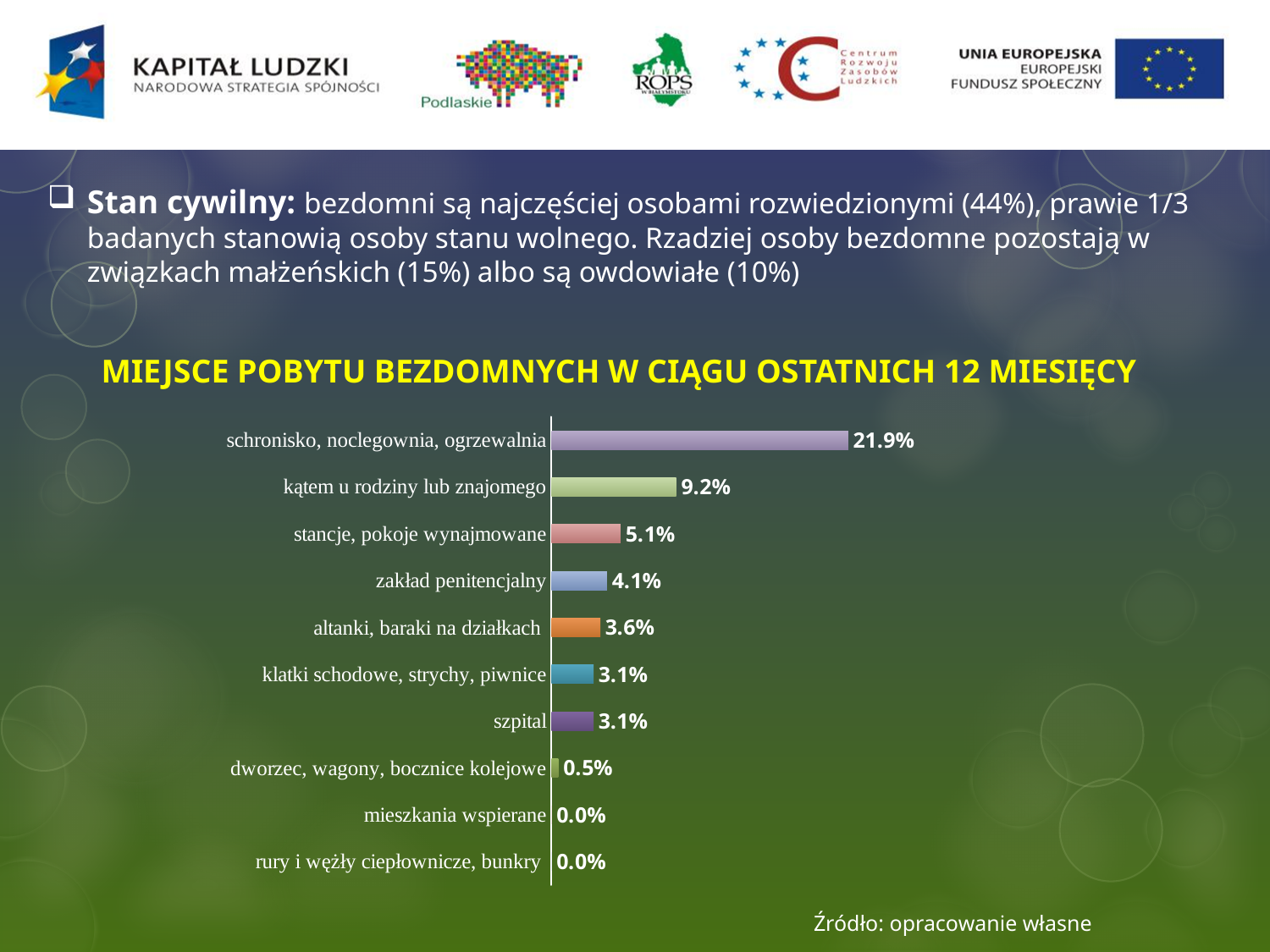
Which is larger: the value for "stancje, pokoje wynajmowane" or the value for "altanki, baraki na działkach"? stancje, pokoje wynajmowane How many categories have a value of 0.0%? 2 What kind of chart is shown on the slide? bar chart How many categories are shown in the chart? 10 What is the value for "kątem u rodziny lub znajomego"? 9.2% What is the value for "schronisko, noclegownia, ogrzewalnia"? 21.9% What is the title of the chart? MIEJSCE POBYTU BEZDOMNYCH W CIĄGU OSTATNICH 12 MIESIĘCY Which category has the highest value? schronisko, noclegownia, ogrzewalnia What is the value for "zakład penitencjalny"? 4.1% What is the value for "dworzec, wagony, bocznice kolejowe"? 0.5% What is the value for "szpital"? 3.1% What is the difference between the values for "schronisko, noclegownia, ogrzewalnia" and "kątem u rodziny lub znajomego"? 12.7%